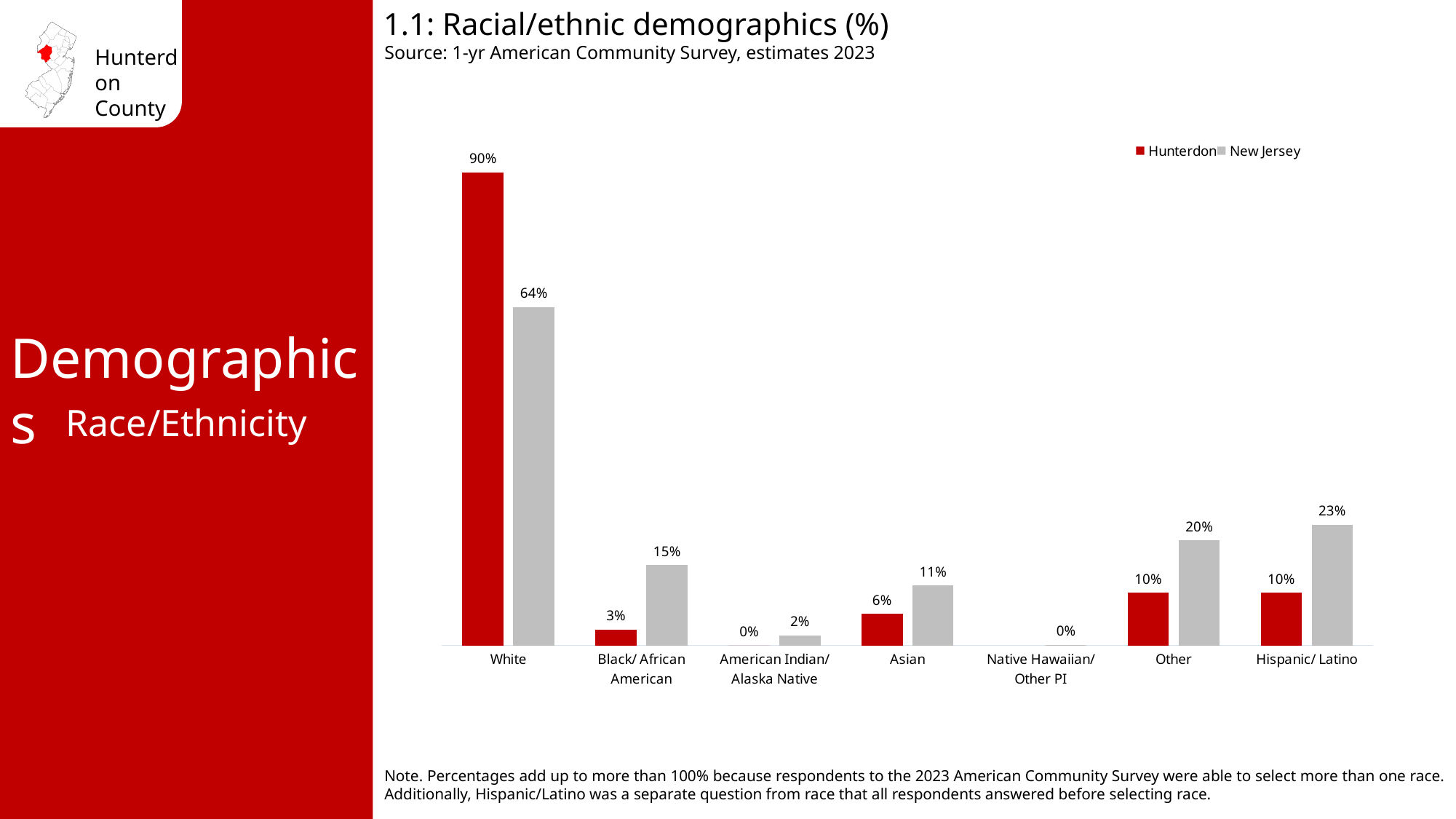
What is the difference between the Hunterdon and New Jersey values for White? 26% How many categories are shown on the x axis? 7 What is the difference between the New Jersey and Hunterdon values for Other? 10% Which is larger for Asian, the Hunterdon value or the New Jersey value? New Jersey Which category has the highest Hunterdon value? White What is the Hunterdon value for Black/ African American? 3% What is the Hunterdon value for White? 90% What is the New Jersey value for Asian? 11% Which category has the lowest New Jersey value? Native Hawaiian/ Other PI What kind of chart is shown on the slide? Bar chart What is the New Jersey value for Hispanic/ Latino? 23% How many series does the legend list? 2